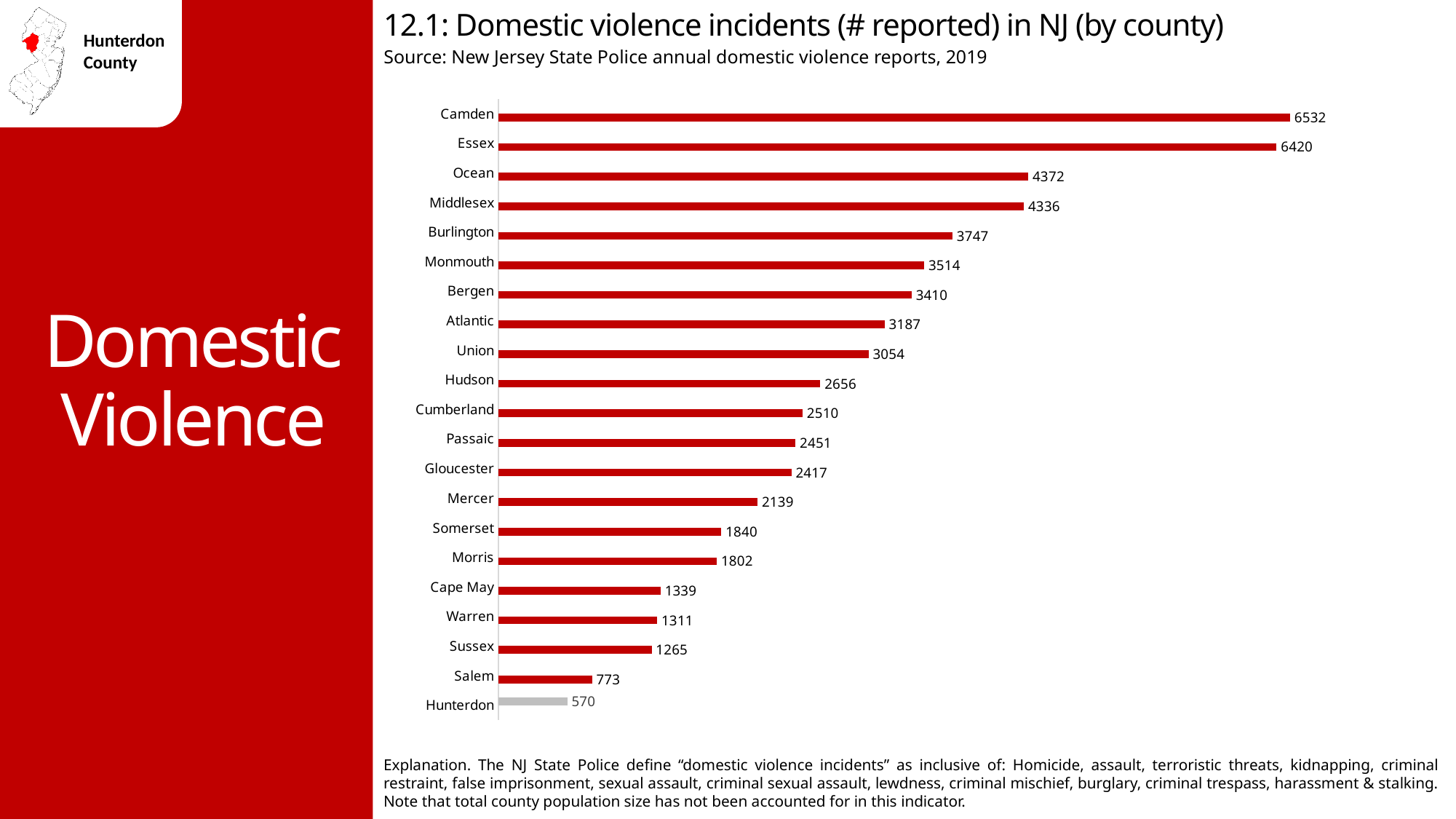
Which county has the highest number of reported domestic violence incidents? Camden What type of chart is used on this slide? Bar chart What is the difference between the values for Camden and Essex? 112 What value is shown for Cape May? 1339 How many more incidents were reported in Salem than in Hunterdon? 203 Which county has the lowest number of reported domestic violence incidents? Hunterdon How many counties are shown in the chart? 21 Which has a higher value, Somerset or Morris? Somerset Which county has more reported incidents, Ocean or Middlesex? Ocean How many domestic violence incidents were reported in Hunterdon County? 570 What is the number of reported domestic violence incidents for Bergen? 3410 Which county's bar is shown in grey rather than red? Hunterdon